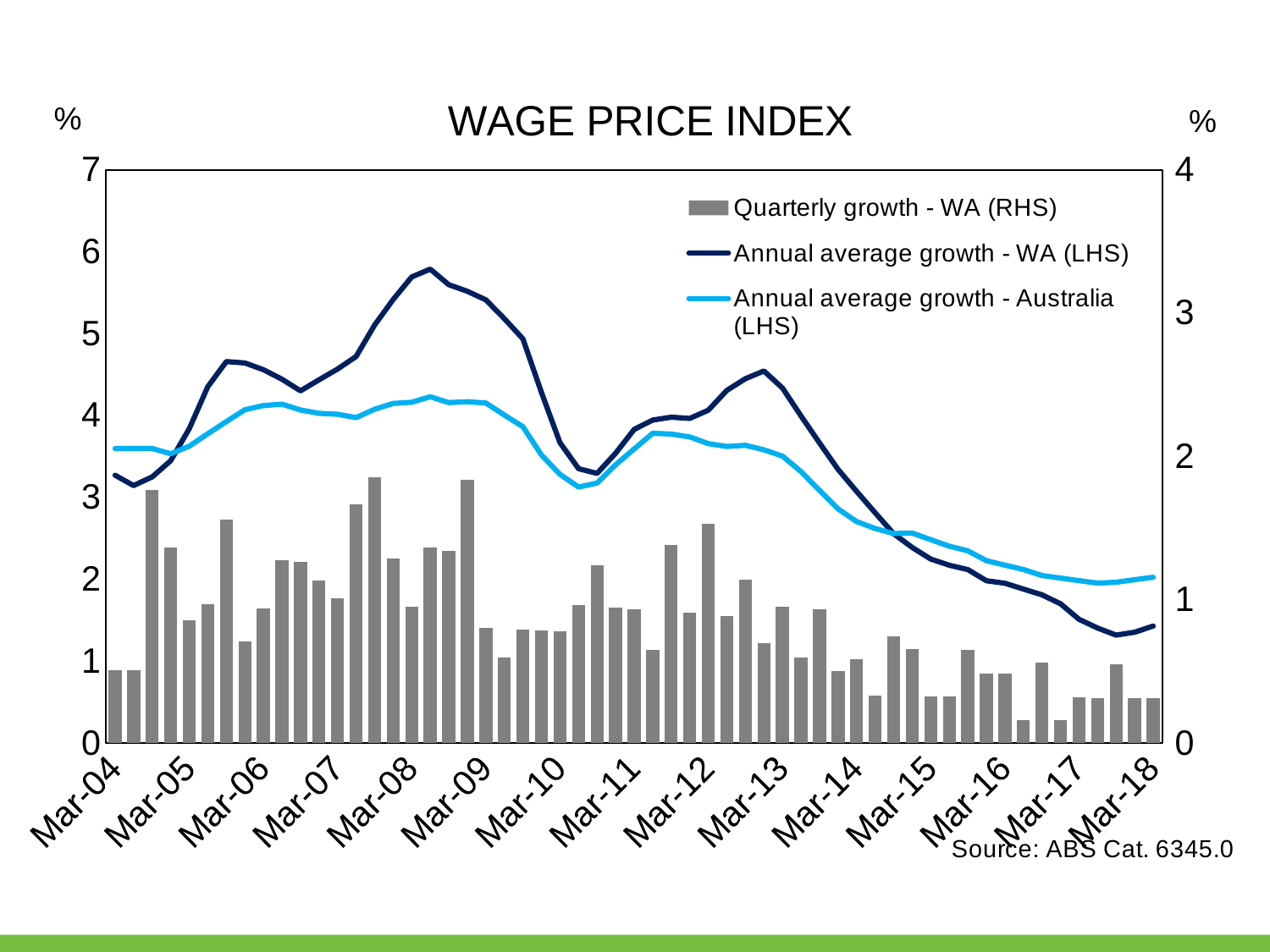
How many year labels are shown on the x axis? 15 How many series does the legend list? 3 Is the value for Quarterly growth - WA (RHS) at Mar-18 greater or less than 1? less At Mar-18, which is higher: Annual average growth - WA or Annual average growth - Australia? Annual average growth - Australia Is the value for Annual average growth - WA (LHS) at Mar-18 greater or less than 2? less What source is cited for the chart? ABS Cat. 6345.0 At Mar-08, which is higher: Annual average growth - WA or Annual average growth - Australia? Annual average growth - WA What is the title of the chart? WAGE PRICE INDEX Does Annual average growth - WA rise or fall between Mar-13 and Mar-18? fall Is the value for Annual average growth - Australia (LHS) at Mar-04 greater or less than 3? greater What kind of chart is this? Combined bar and line chart